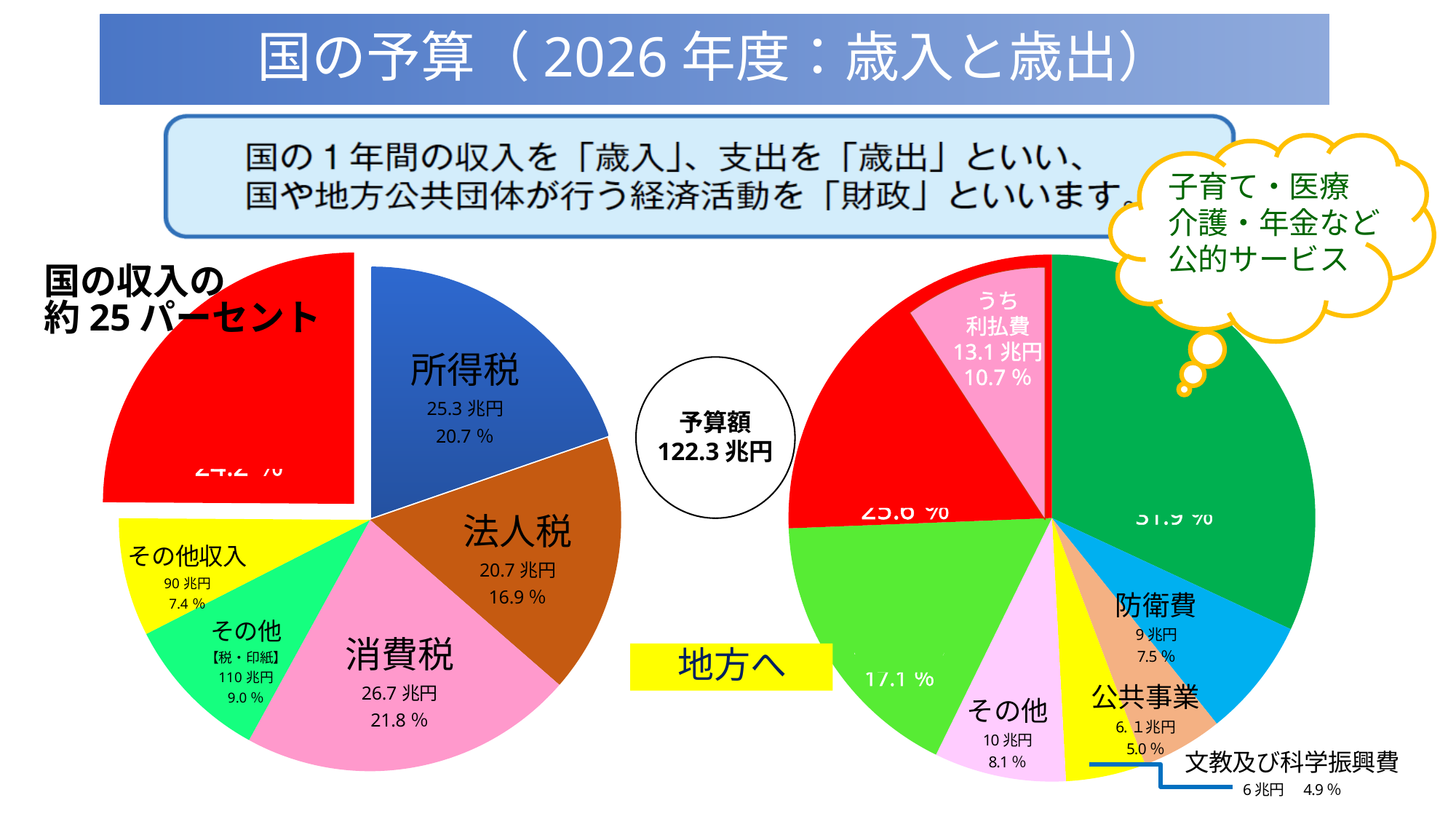
How many slices does the left pie chart have? 6 In the left pie chart, what is the value for 所得税? 25.3 兆円 In the right pie chart, what is the value for 防衛費? 9 兆円 What kind of chart is the left chart showing 所得税, 法人税 and 消費税? pie chart In the left pie chart, which is larger, 消費税 or 所得税? 消費税 In the left pie chart, what percentage share is shown for 消費税? 21.8 % In the left pie chart, what percentage share is shown for その他収入? 7.4 % What total budget amount (予算額) is shown in the circle between the two pie charts? 122.3 兆円 In the right pie chart, what percentage share is shown for 文教及び科学振興費? 4.9 % In the right pie chart, what is the difference between 防衛費 and 公共事業? 2.9 兆円 In the left pie chart, what is the value for 法人税? 20.7 兆円 In the left pie chart, what is the difference between 所得税 and 法人税? 4.6 兆円